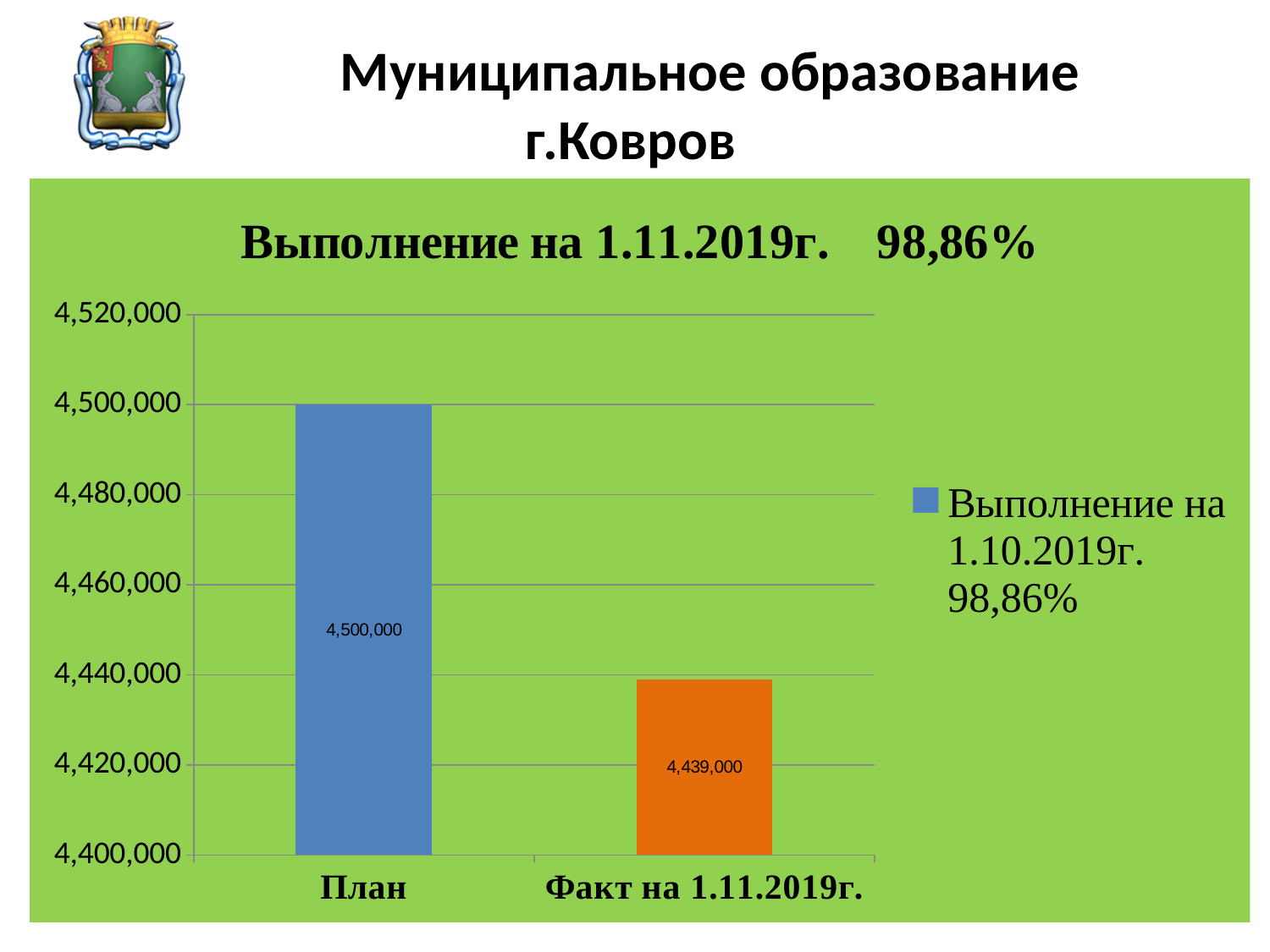
Which category has the lowest value? Факт на 1.11.2019г. Which is larger, the value for План or the value for Факт на 1.11.2019г.? План What is the title of the chart? Выполнение на 1.11.2019г. 98,86% How many series does the legend list? 1 What kind of chart is shown on the slide? bar chart What is the difference between the value for План and the value for Факт на 1.11.2019г.? 61,000 How many categories are shown on the x axis? 2 What colour is the bar for План? blue Which category has the highest value? План Is the value for Факт на 1.11.2019г. greater or less than 4,440,000? less What is the value for План? 4,500,000 What is the value for Факт на 1.11.2019г.? 4,439,000